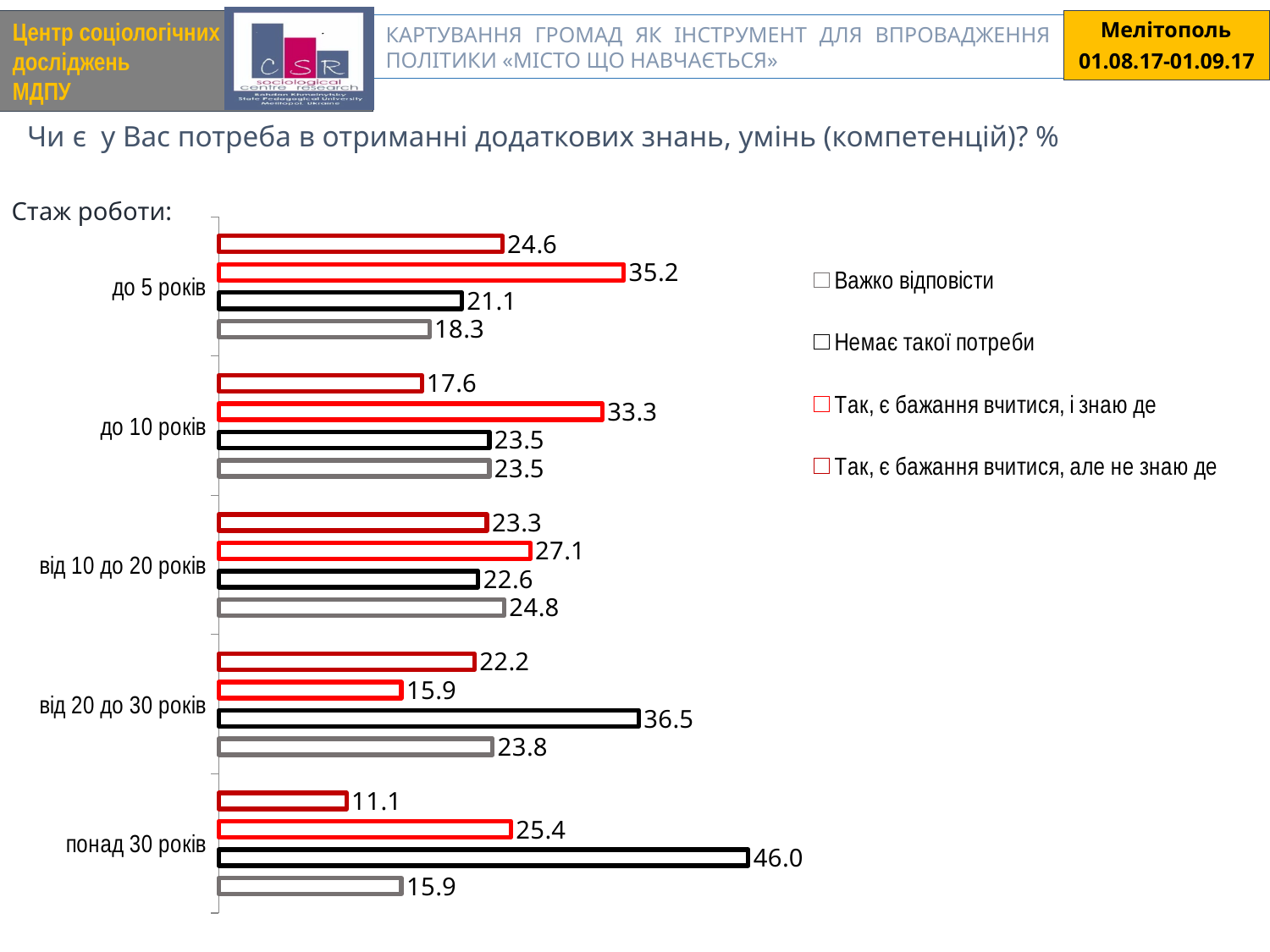
Which work-experience category has the lowest value for "Важко відповісти"? понад 30 років Which is larger for "від 20 до 30 років": "Немає такої потреби" or "Важко відповісти"? Немає такої потреби How many series does the legend list? 4 What is the title of the chart? Чи є у Вас потреба в отриманні додаткових знань, умінь (компетенцій)? % What is the value of "Важко відповісти" for "до 5 років"? 18.3 What is the value of "Немає такої потреби" for "від 20 до 30 років"? 36.5 Which work-experience category has the highest value for "Немає такої потреби"? понад 30 років What is the value of "Так, є бажання вчитися, і знаю де" for "до 10 років"? 33.3 What type of chart is shown on the slide? bar chart How many work-experience categories are shown on the chart? 5 What is the difference between "Немає такої потреби" for "понад 30 років" and for "до 5 років"? 24.9 What is the value of "Немає такої потреби" for "понад 30 років"? 46.0